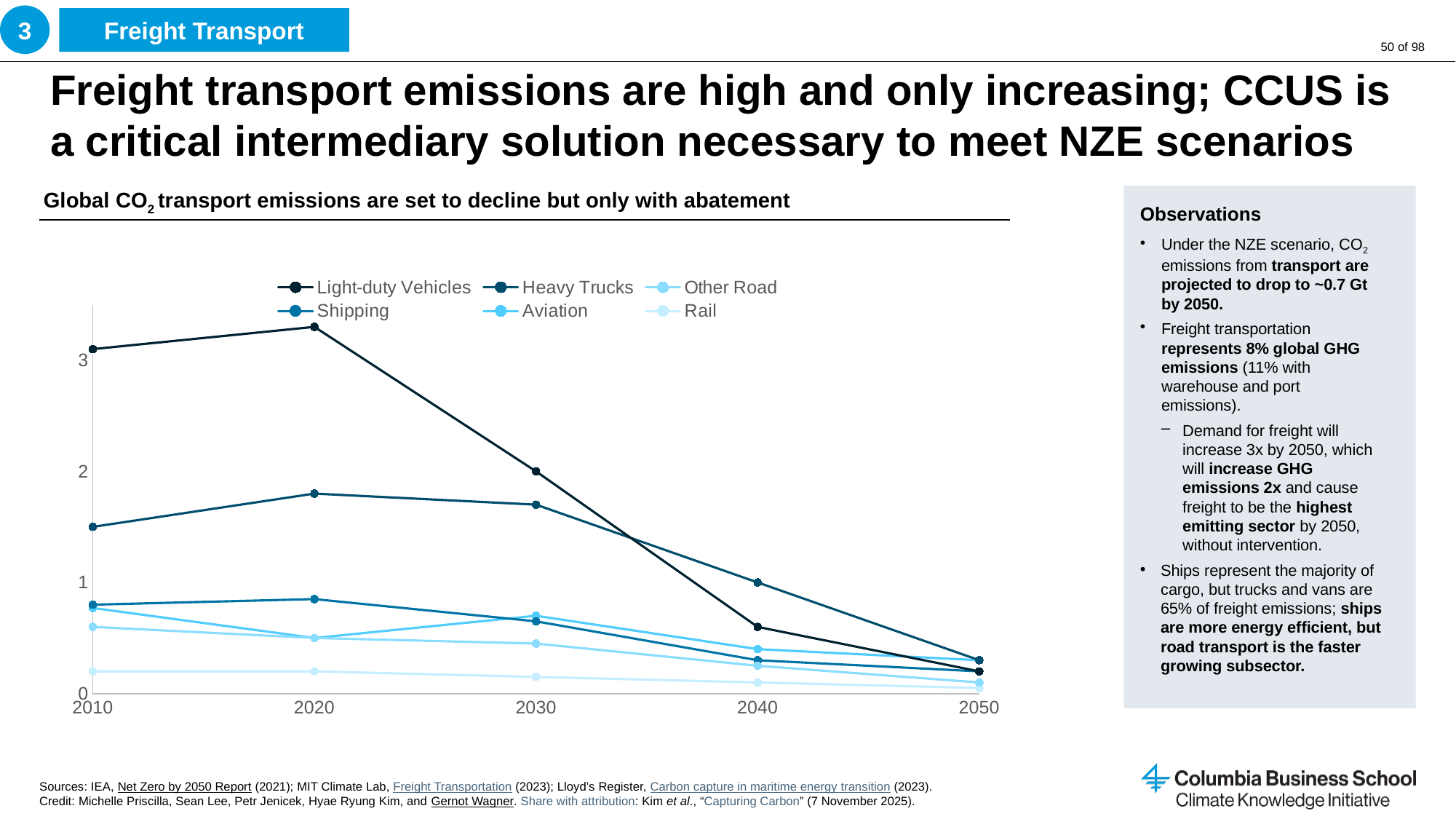
How many years are shown along the x axis of the chart? 5 How many series does the chart legend list? 6 Do the values for Light-duty Vehicles rise or fall from 2020 to 2050? Fall Which series has the lowest value in 2010? Rail Is the value for Heavy Trucks in 2020 greater or less than 2? less What kind of chart is shown on the slide? Line chart Is the value for Light-duty Vehicles in 2020 greater or less than 3? greater Is the value for Shipping in 2010 greater or less than 1? less Which is larger in 2030, Light-duty Vehicles or Heavy Trucks? Light-duty Vehicles What is the title of the chart? Global CO2 transport emissions are set to decline but only with abatement Which series has the highest value in 2020? Light-duty Vehicles Which is larger in 2040, Light-duty Vehicles or Heavy Trucks? Heavy Trucks